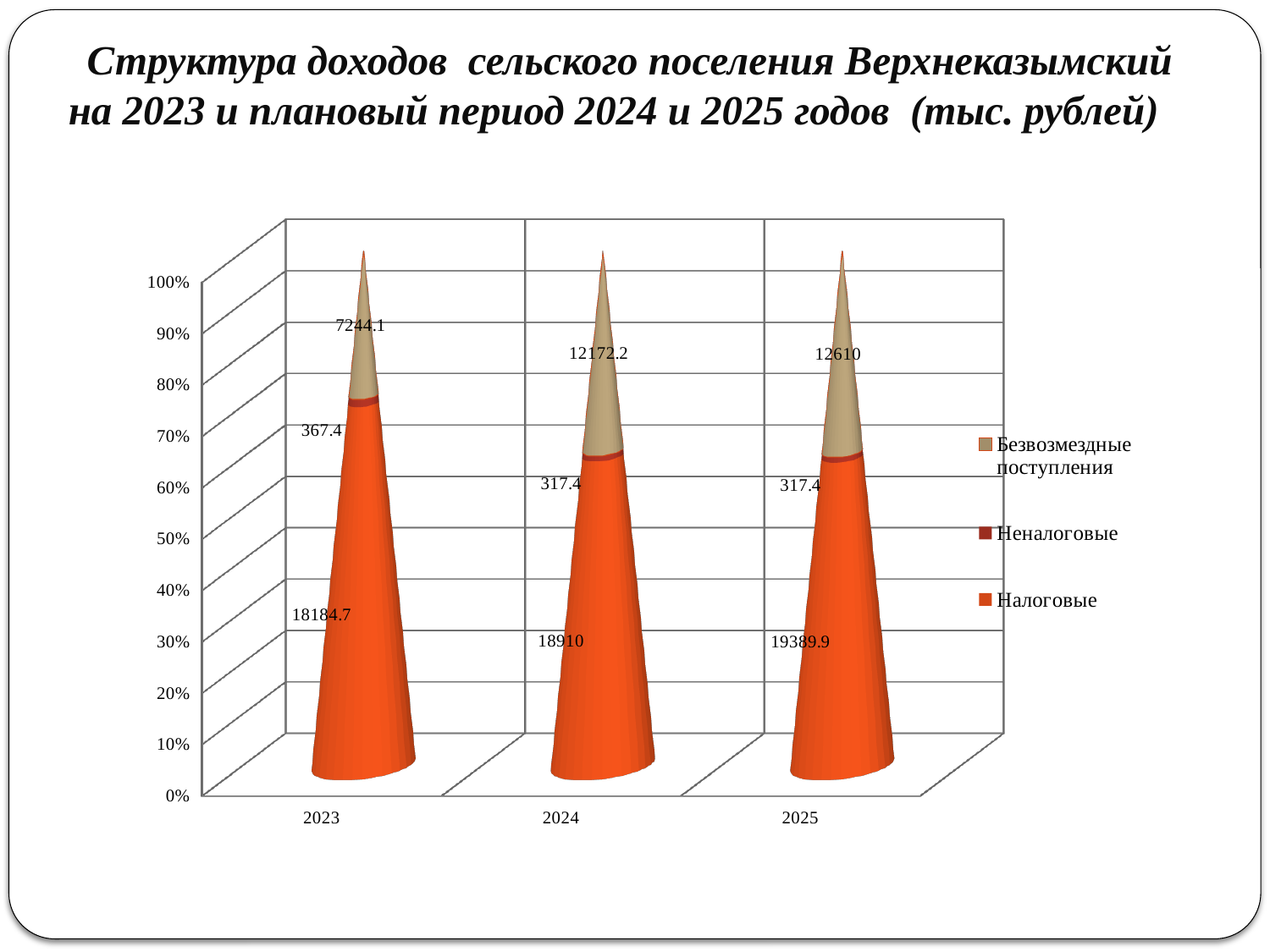
What is the difference between the Налоговые values for 2025 and 2023? 1205.2 What is the total of the three values for 2024? 31399.6 How many years are shown on the x axis? 3 What is the value of Безвозмездные поступления for 2024? 12172.2 What is the value of Неналоговые for 2025? 317.4 How many series does the legend list? 3 In which year is the Безвозмездные поступления value lowest? 2023 What is the value of Безвозмездные поступления for 2025? 12610 Does the Налоговые value rise or fall from 2023 to 2025? rise Which is larger: Неналоговые for 2023 or Неналоговые for 2024? 2023 In which year is the Налоговые value highest? 2025 What is the value of Налоговые for 2023? 18184.7